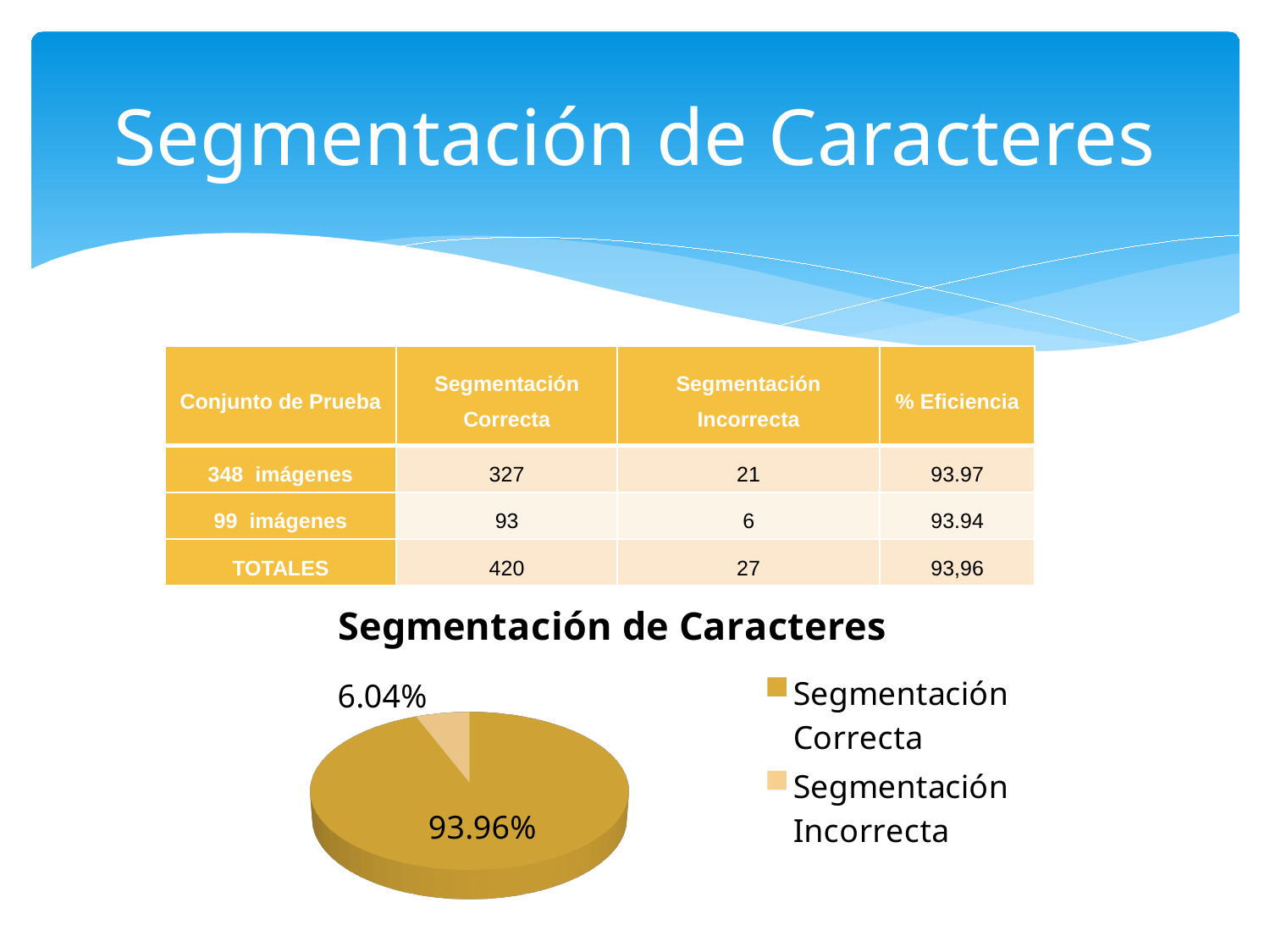
How many slices does the pie chart have? 2 How many entries does the legend list? 2 What is the title of the chart? Segmentación de Caracteres What is the difference in percentage points between the Segmentación Correcta and Segmentación Incorrecta slices? 87.92 What share of the pie does Segmentación Correcta represent? 93.96% Which slice of the pie is the largest? Segmentación Correcta Which legend entry is shown in the lighter shade of gold? Segmentación Incorrecta Which slice of the pie is the smallest? Segmentación Incorrecta What share of the pie does Segmentación Incorrecta represent? 6.04% Which is larger, the share for Segmentación Correcta or for Segmentación Incorrecta? Segmentación Correcta What kind of chart is shown on the slide? pie chart